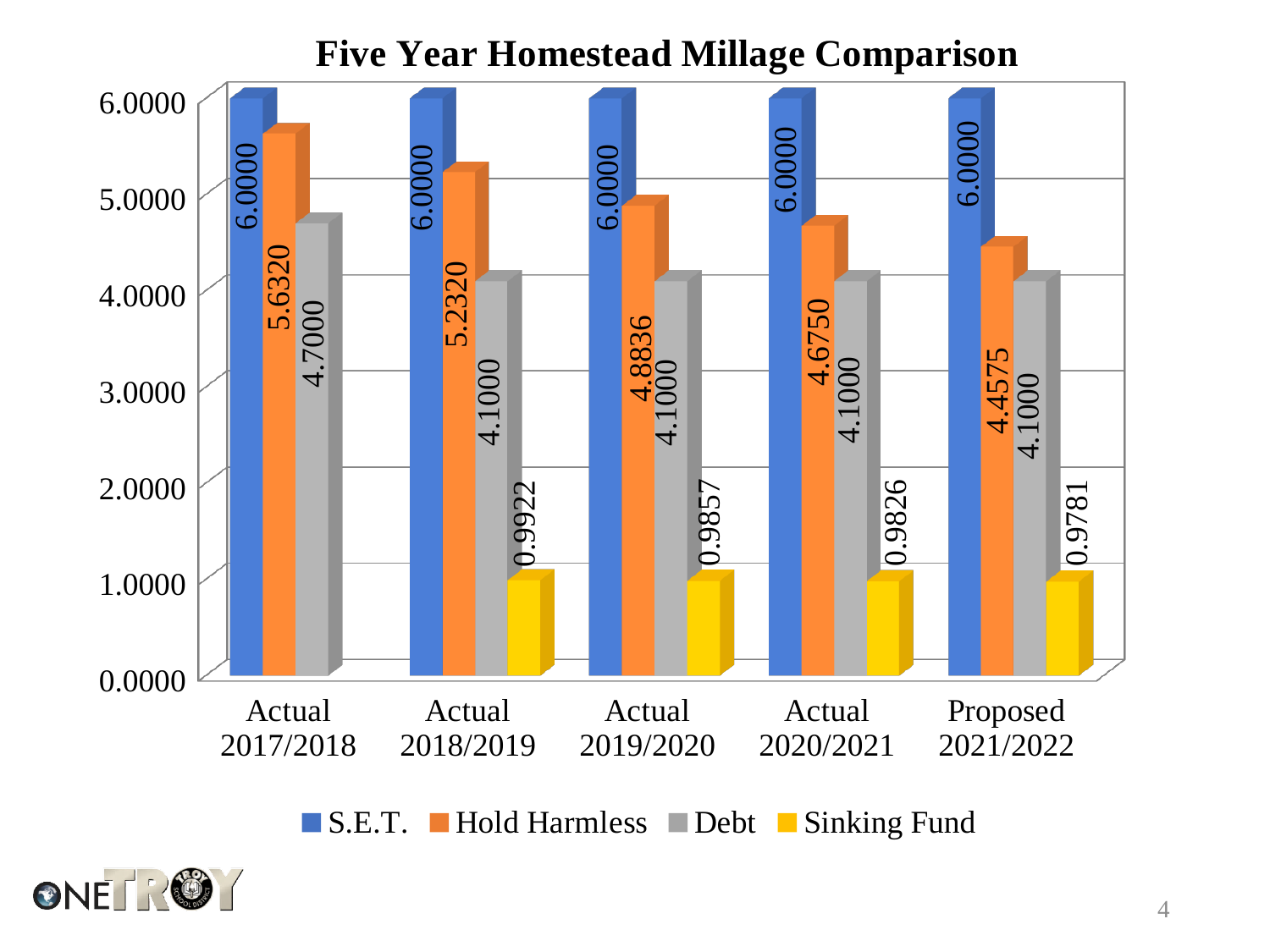
What is the Hold Harmless value for Actual 2019/2020? 4.8836 What is the Hold Harmless value for Actual 2017/2018? 5.6320 Does the Hold Harmless value rise or fall from Actual 2017/2018 to Proposed 2021/2022? Fall Which is larger, the Sinking Fund value for Actual 2018/2019 or for Actual 2020/2021? Actual 2018/2019 What is the difference between the Hold Harmless values for Actual 2017/2018 and Actual 2018/2019? 0.4000 In which year is the Debt value highest? Actual 2017/2018 How many year categories are shown on the x axis? 5 What is the Sinking Fund value for Proposed 2021/2022? 0.9781 What is the Debt value for Actual 2017/2018? 4.7000 In which year is the Hold Harmless value lowest? Proposed 2021/2022 What kind of chart is shown on the slide? Bar chart How many series does the legend list? 4